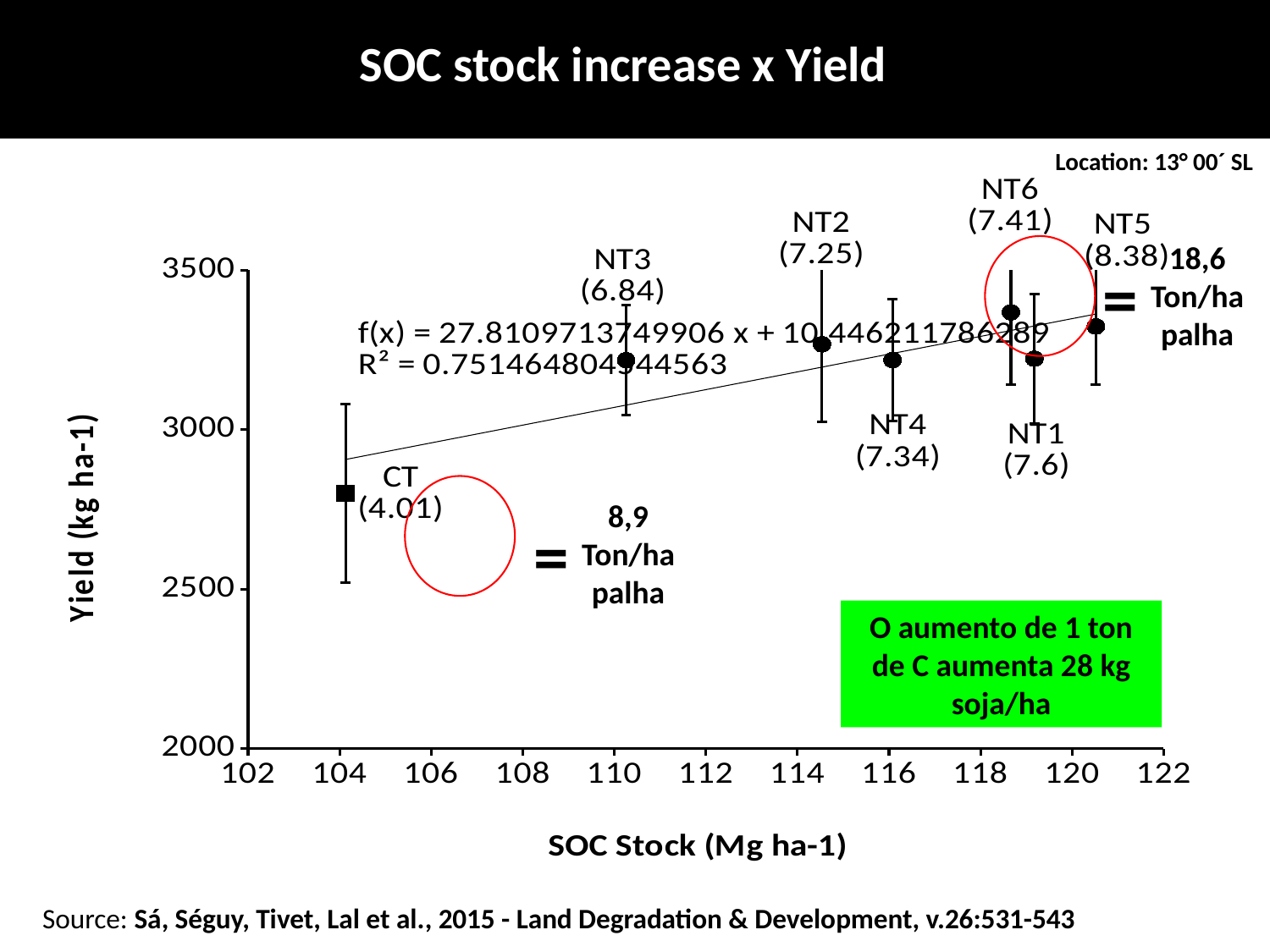
What value is shown in parentheses next to the CT point? 4.01 What value is shown in parentheses next to the NT3 point? 6.84 What is the title of the chart? SOC stock increase x Yield Which labelled point has the lowest value in parentheses? CT Does yield rise or fall as SOC stock increases along the x axis? rise What is the label of the x axis? SOC Stock (Mg ha-1) Which has the larger value in parentheses, NT1 or NT4? NT1 What is the difference between the values in parentheses for NT5 and CT? 4.37 What kind of chart is shown on the slide? Scatter chart Is the yield value for CT greater or less than 3000? less Which labelled point has the highest value in parentheses? NT5 How many data points are plotted on the chart? 7